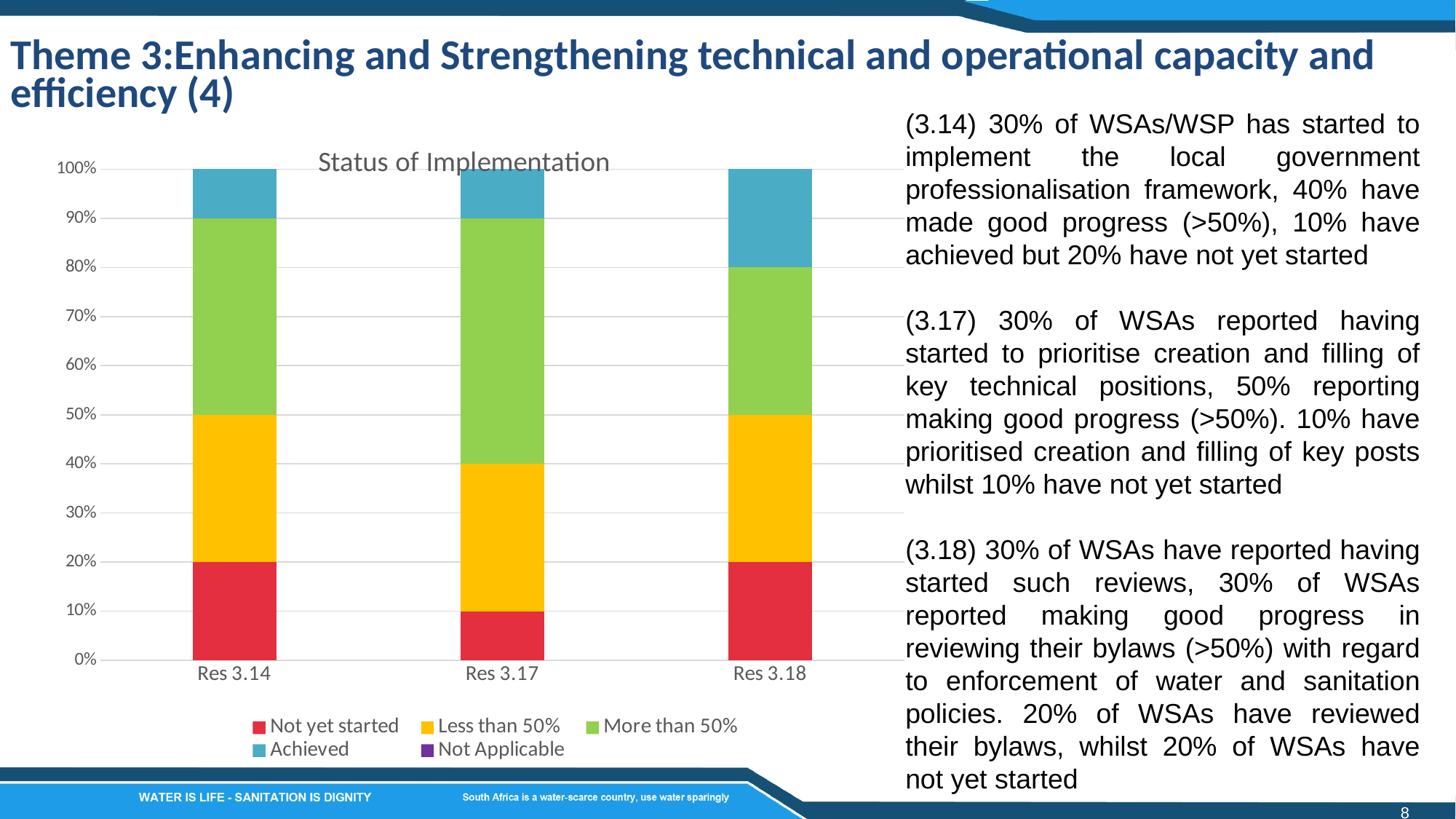
What is the 'Not yet started' value for Res 3.14? 20% Which category has the smallest 'Not yet started' segment? Res 3.17 Which category has the largest 'Achieved' segment? Res 3.18 Is the 'More than 50%' value for Res 3.17 greater or less than 30%? greater How many series does the legend of the Status of Implementation chart list? 5 Is the 'Achieved' segment larger for Res 3.18 or for Res 3.14? Res 3.18 How many categories are shown on the x axis of the Status of Implementation chart? 3 What is the 'Not yet started' value for Res 3.17? 10% What kind of chart is shown on the slide? Stacked bar chart What is the total height of the stacked bar for Res 3.14? 100% Is the 'Achieved' value for Res 3.14 greater or less than 20%? less What is the title of the chart? Status of Implementation